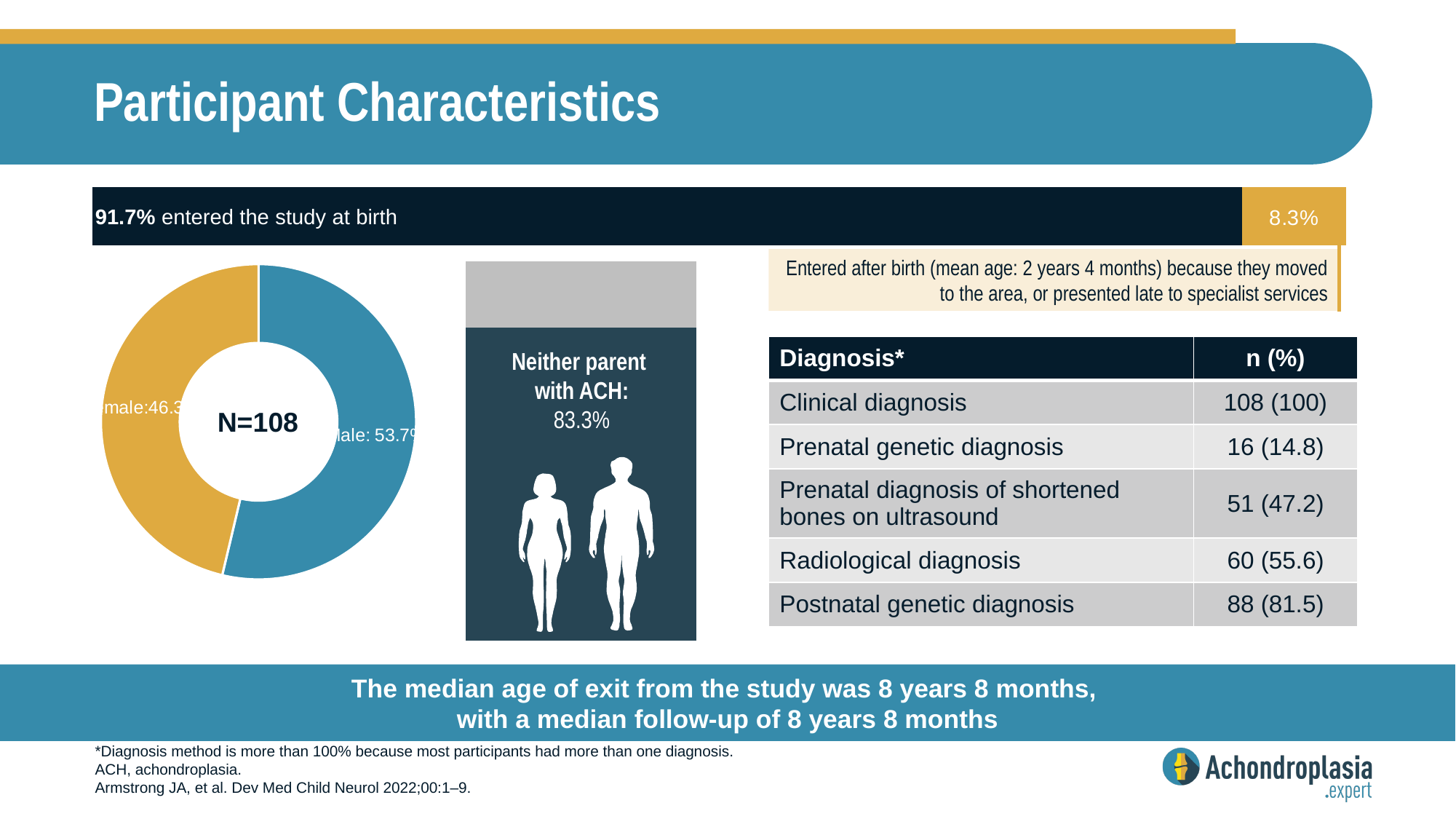
In the donut chart, which slice is larger, the blue one or the orange one? Blue What percentage is printed on the orange slice of the donut chart? 46.3% What kind of chart is shown on the left of the slide? Pie (donut) chart What total N is printed in the centre of the donut chart? N=108 In the horizontal bar at the top of the slide, what percentage is shown in the orange segment? 8.3% What colour is the larger slice of the donut chart? Blue How many slices does the donut chart have? 2 In the horizontal bar at the top of the slide, which segment is larger, the dark one or the orange one? Dark What percentage is printed on the blue slice of the donut chart? 53.7% Is the orange slice of the donut chart greater or less than 50%? less In the horizontal bar at the top of the slide, what percentage entered the study at birth? 91.7% What is the difference between the blue slice (53.7%) and the orange slice (46.3%) in the donut chart? 7.4%